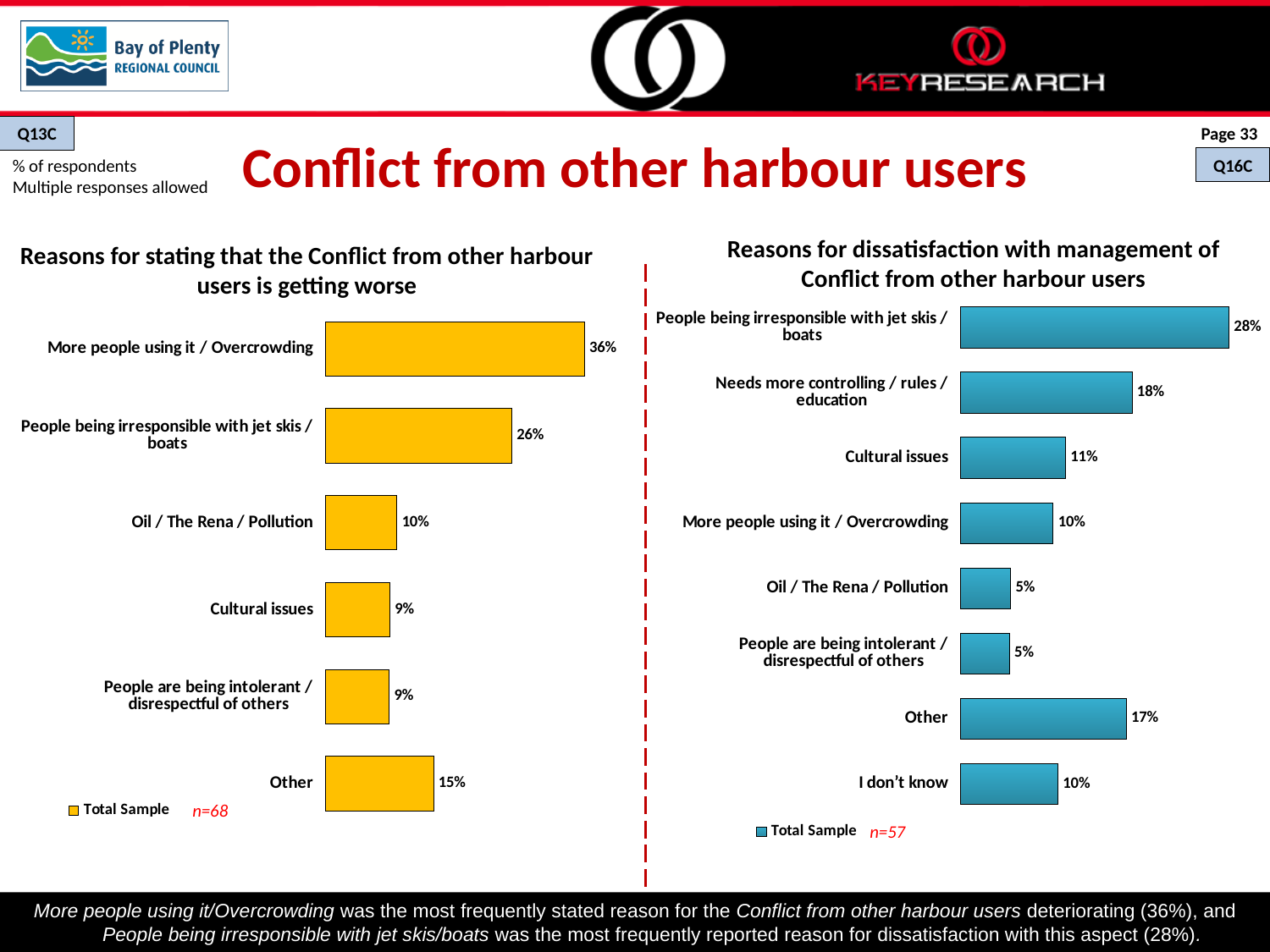
In the right chart 'Reasons for dissatisfaction with management of Conflict from other harbour users', what is the difference between 'People being irresponsible with jet skis / boats' and 'Other'? 11% In the right chart 'Reasons for dissatisfaction with management of Conflict from other harbour users', which category has the highest value? People being irresponsible with jet skis / boats In the left chart 'Reasons for stating that the Conflict from other harbour users is getting worse', what is the value for 'More people using it / Overcrowding'? 36% In the right chart 'Reasons for dissatisfaction with management of Conflict from other harbour users', what is the value for 'Needs more controlling / rules / education'? 18% How many categories are shown in the right chart 'Reasons for dissatisfaction with management of Conflict from other harbour users'? 8 In the left chart 'Reasons for stating that the Conflict from other harbour users is getting worse', what is the difference between 'More people using it / Overcrowding' and 'People being irresponsible with jet skis / boats'? 10% In the left chart 'Reasons for stating that the Conflict from other harbour users is getting worse', which is larger: 'Oil / The Rena / Pollution' or 'Other'? Other What type of chart is the left chart 'Reasons for stating that the Conflict from other harbour users is getting worse'? Bar chart In the left chart 'Reasons for stating that the Conflict from other harbour users is getting worse', what is the value for 'Other'? 15% In the left chart 'Reasons for stating that the Conflict from other harbour users is getting worse', which category has the highest value? More people using it / Overcrowding In the right chart 'Reasons for dissatisfaction with management of Conflict from other harbour users', which category has the lowest value? Oil / The Rena / Pollution and People are being intolerant / disrespectful of others (both 5%) How many categories are shown in the left chart 'Reasons for stating that the Conflict from other harbour users is getting worse'? 6